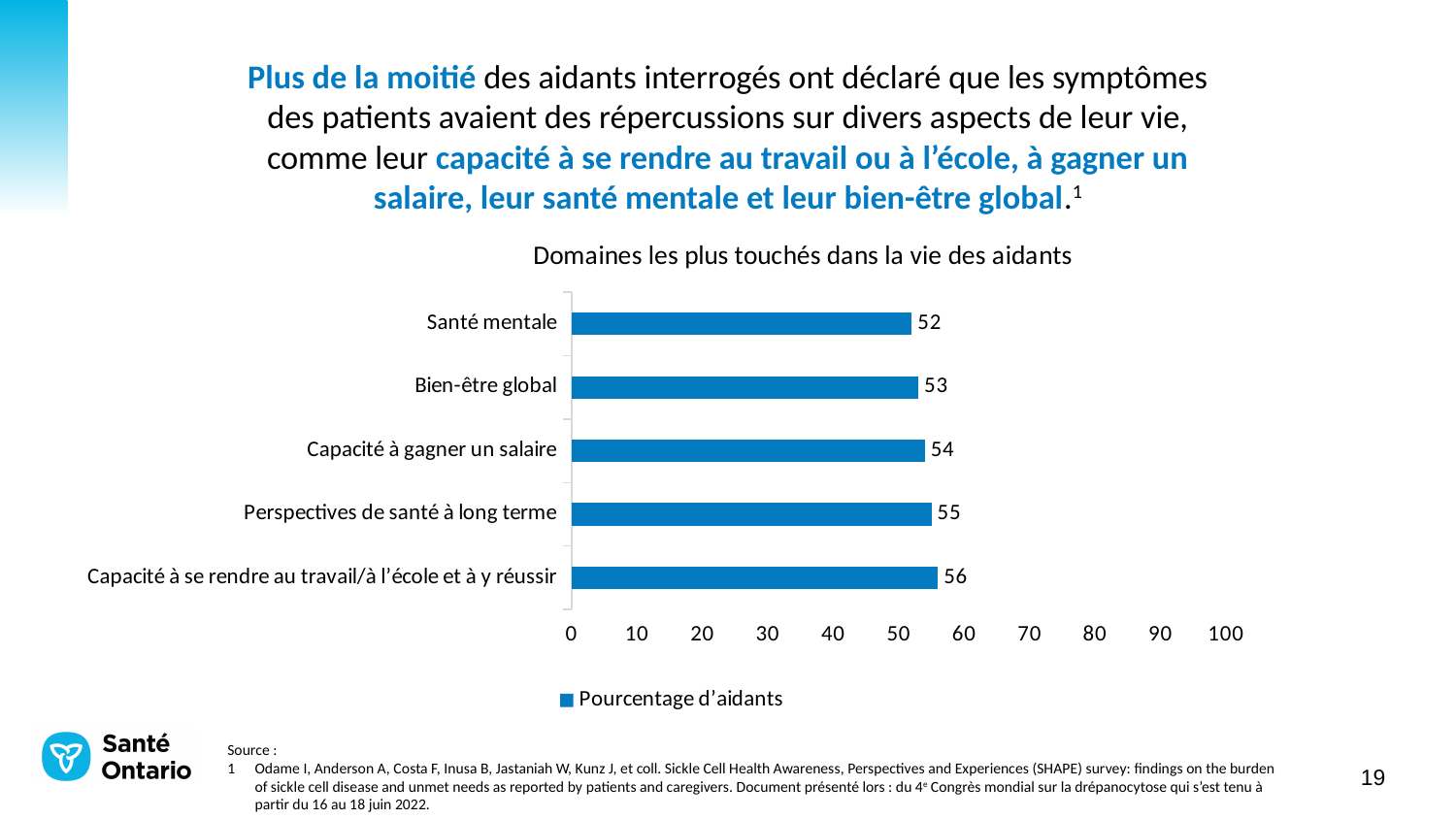
What kind of chart is shown on the slide? Bar chart Is the value for Perspectives de santé à long terme greater or less than 50? greater What is the title of the chart? Domaines les plus touchés dans la vie des aidants What is the difference between the values for Perspectives de santé à long terme and Santé mentale? 3 What is the value for Capacité à se rendre au travail/à l'école et à y réussir? 56 How many series does the legend list? 1 Which category has the highest value? Capacité à se rendre au travail/à l'école et à y réussir What is the value for Santé mentale? 52 What is the value for Capacité à gagner un salaire? 54 How many categories are shown in the chart? 5 Which category has the lowest value? Santé mentale Which is larger, the value for Bien-être global or the value for Capacité à gagner un salaire? Capacité à gagner un salaire